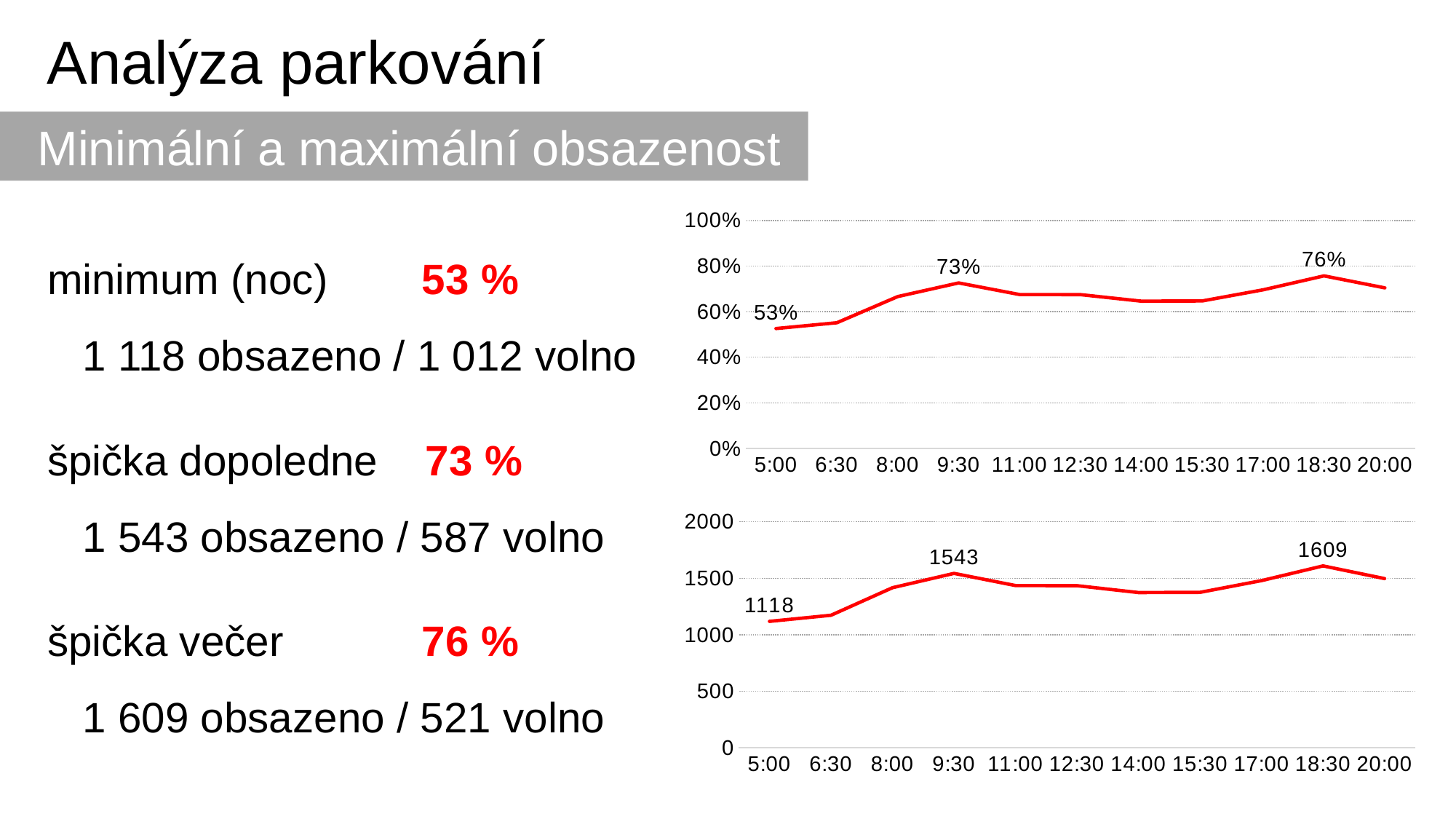
In the bottom chart (counts), what is the difference between the labelled values at 18:30 and 9:30? 66 In the bottom chart (counts), is the value at 14:00 greater or less than 1500? less In the top chart (percentages), does the value rise or fall between 5:00 and 9:30? rise In the top chart (percentages), at which time is the plotted value lowest? 5:00 In the top chart (percentages), what value is labelled at 18:30? 76% In the bottom chart (counts), what value is labelled at 18:30? 1609 What kind of chart is the bottom chart? line chart In the top chart (percentages), which is larger, the value at 9:30 or the value at 18:30? 18:30 How many time points are shown on the x axis of the top chart? 11 In the bottom chart (counts), at which time is the plotted value highest? 18:30 In the top chart (percentages), what value is labelled at 9:30? 73% In the bottom chart (counts), what value is labelled at 5:00? 1118